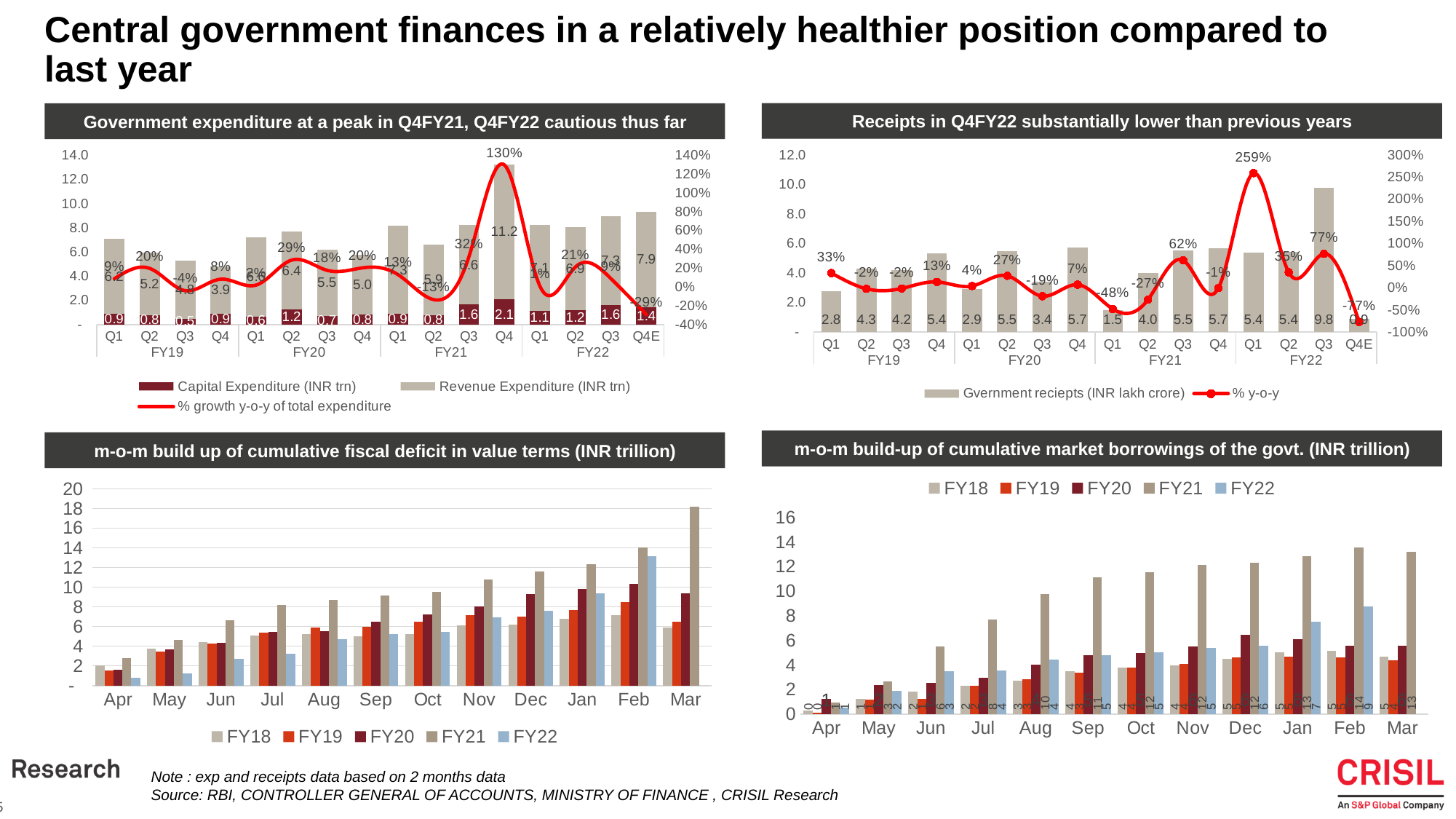
How many series does the legend list in the 'm-o-m build up of cumulative fiscal deficit in value terms (INR trillion)' chart? 5 In the 'Receipts in Q4FY22 substantially lower than previous years' chart, which quarter has the highest government receipts? Q3 FY22 In the 'Government expenditure at a peak in Q4FY21, Q4FY22 cautious thus far' chart, what is the Revenue Expenditure (INR trn) for Q4 FY21? 11.2 In the 'Government expenditure at a peak in Q4FY21, Q4FY22 cautious thus far' chart, what is the % growth y-o-y of total expenditure for Q4E FY22? -29% In the 'Receipts in Q4FY22 substantially lower than previous years' chart, which quarter has the lowest government receipts? Q4E FY22 In the 'Government expenditure at a peak in Q4FY21, Q4FY22 cautious thus far' chart, what is the total of the stacked bar (capital plus revenue expenditure) for Q4E FY22? 9.3 What kind of chart is the 'm-o-m build-up of cumulative market borrowings of the govt. (INR trillion)' chart? bar chart In the 'Receipts in Q4FY22 substantially lower than previous years' chart, what is the % y-o-y value for Q1 FY22? 259% In the 'Receipts in Q4FY22 substantially lower than previous years' chart, which is larger: government receipts in Q2 FY19 or Q2 FY20? Q2 FY20 In the 'Receipts in Q4FY22 substantially lower than previous years' chart, what is the difference between government receipts in Q3 FY22 and Q4E FY22? 8.9 In the 'Government expenditure at a peak in Q4FY21, Q4FY22 cautious thus far' chart, what is the Capital Expenditure (INR trn) for Q4 FY21? 2.1 In the 'm-o-m build up of cumulative fiscal deficit in value terms (INR trillion)' chart, is the FY21 value for Mar greater or less than 16? greater